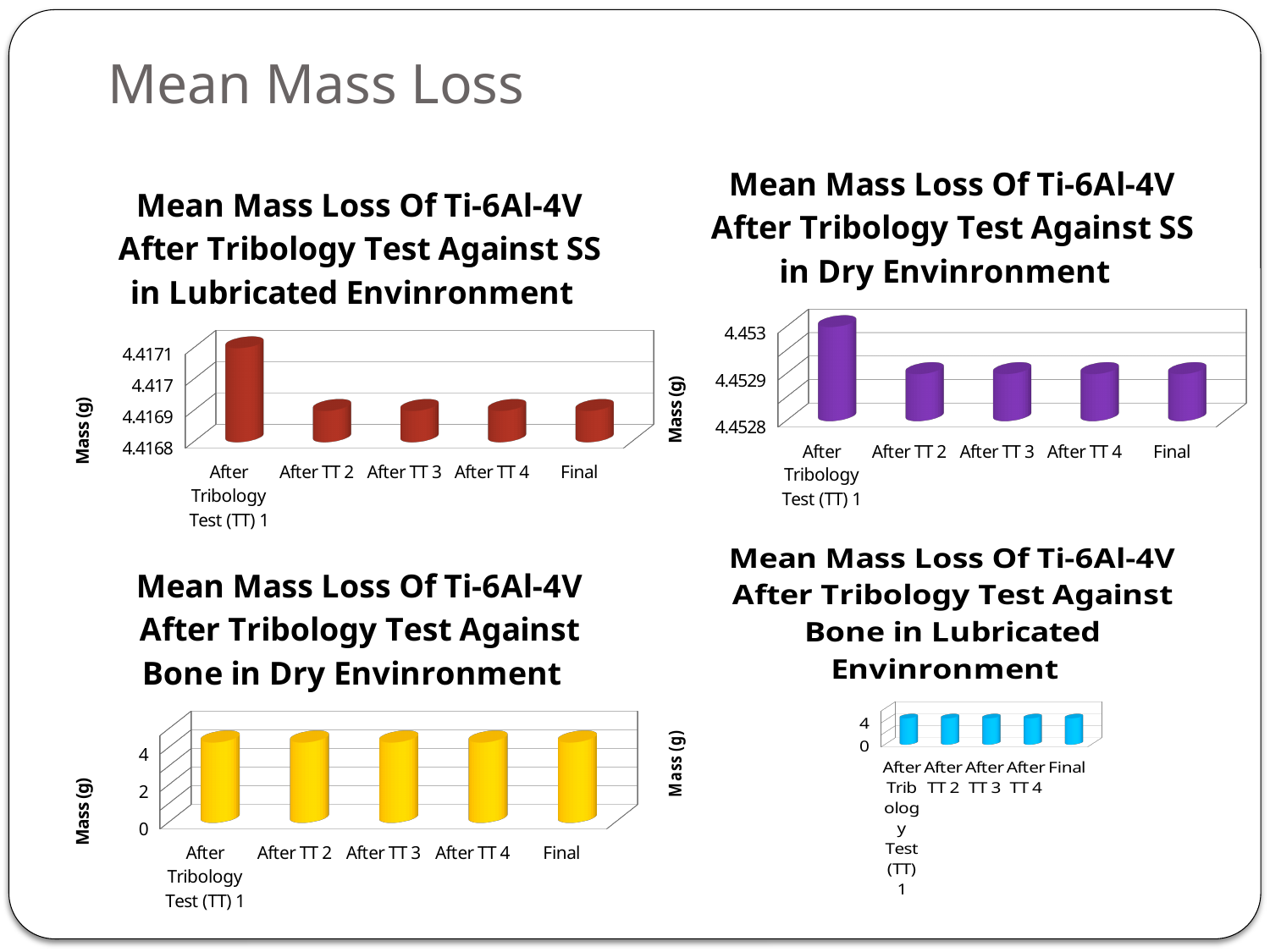
What colour are the bars in the 'Mean Mass Loss Of Ti-6Al-4V After Tribology Test Against SS in Dry Envinronment' chart? purple What is the y-axis label of the 'Mean Mass Loss Of Ti-6Al-4V After Tribology Test Against Bone in Dry Envinronment' chart? Mass (g) What kind of chart is the 'Mean Mass Loss Of Ti-6Al-4V After Tribology Test Against SS in Lubricated Envinronment' chart? bar chart In the 'Mean Mass Loss Of Ti-6Al-4V After Tribology Test Against SS in Lubricated Envinronment' chart, which category has the highest mass? After Tribology Test (TT) 1 In the 'Mean Mass Loss Of Ti-6Al-4V After Tribology Test Against SS in Dry Envinronment' chart, is the value for After Tribology Test (TT) 1 greater or less than 4.4529? greater In the 'Mean Mass Loss Of Ti-6Al-4V After Tribology Test Against Bone in Dry Envinronment' chart, is the value for After TT 4 greater or less than 2? greater In the 'Mean Mass Loss Of Ti-6Al-4V After Tribology Test Against SS in Dry Envinronment' chart, is the value for Final greater or less than 4.453? less In the 'Mean Mass Loss Of Ti-6Al-4V After Tribology Test Against SS in Dry Envinronment' chart, which is larger, the value for After Tribology Test (TT) 1 or the value for After TT 3? After Tribology Test (TT) 1 In the 'Mean Mass Loss Of Ti-6Al-4V After Tribology Test Against SS in Dry Envinronment' chart, which category has the highest mass? After Tribology Test (TT) 1 In the 'Mean Mass Loss Of Ti-6Al-4V After Tribology Test Against SS in Lubricated Envinronment' chart, how many categories are shown on the x axis? 5